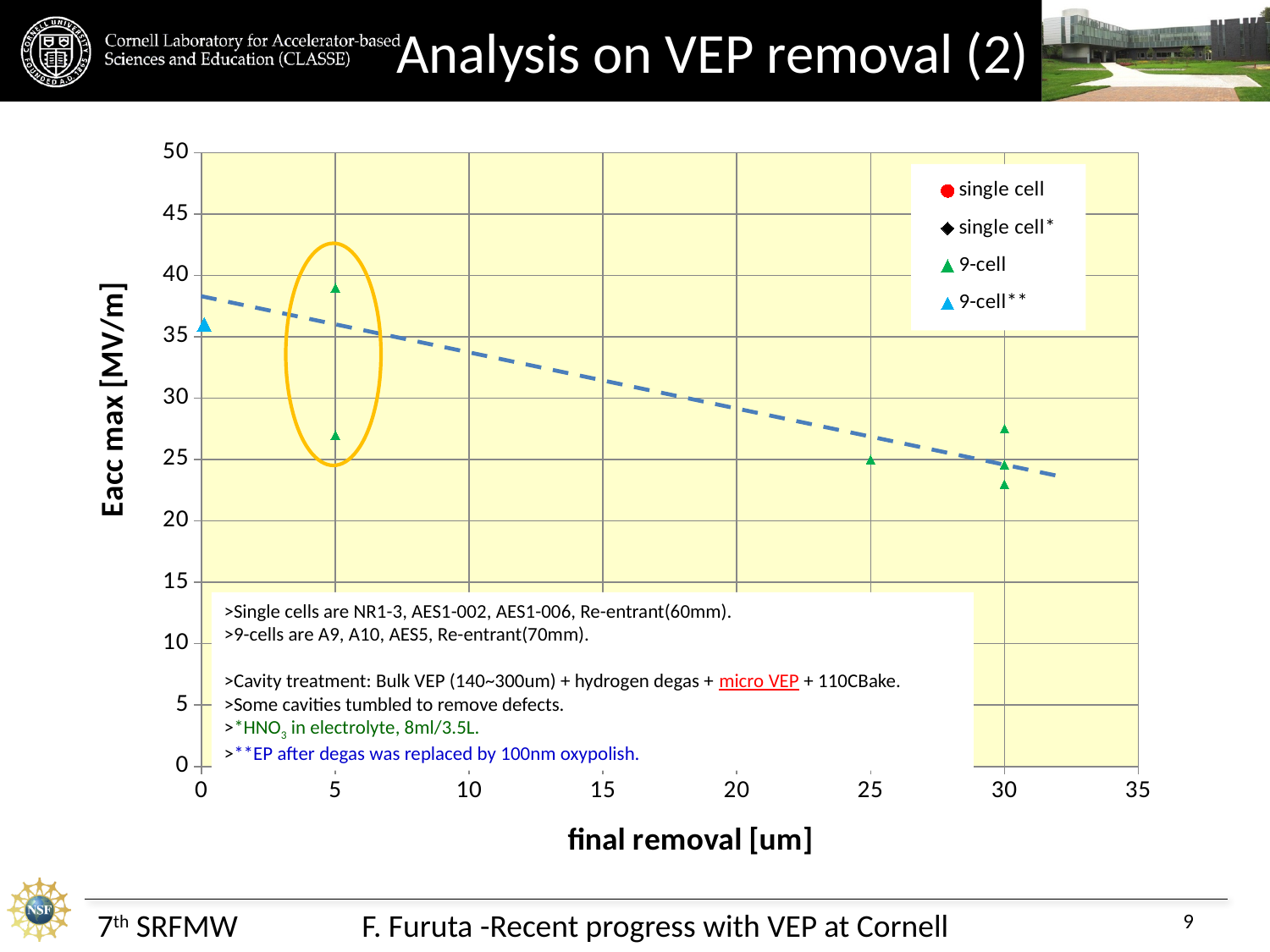
How many series does the chart legend list? 4 What is the label of the y axis? Eacc max [MV/m] Is the 9-cell** point at a final removal of 0 um greater or less than 30 MV/m? greater Is the highest 9-cell point at a final removal of 5 um greater or less than 35 MV/m? greater What kind of chart is shown on the slide? scatter chart Does the dashed trend line rise or fall as final removal increases? fall What is the label of the x axis? final removal [um] Is the lower 9-cell point at a final removal of 5 um greater or less than 25 MV/m? greater At which final removal value does the 9-cell series reach its highest Eacc max? 5 How many 9-cell (green triangle) data points are plotted on the chart? 6 Which is larger: the highest 9-cell point at 5 um or the highest 9-cell point at 30 um? the highest 9-cell point at 5 um